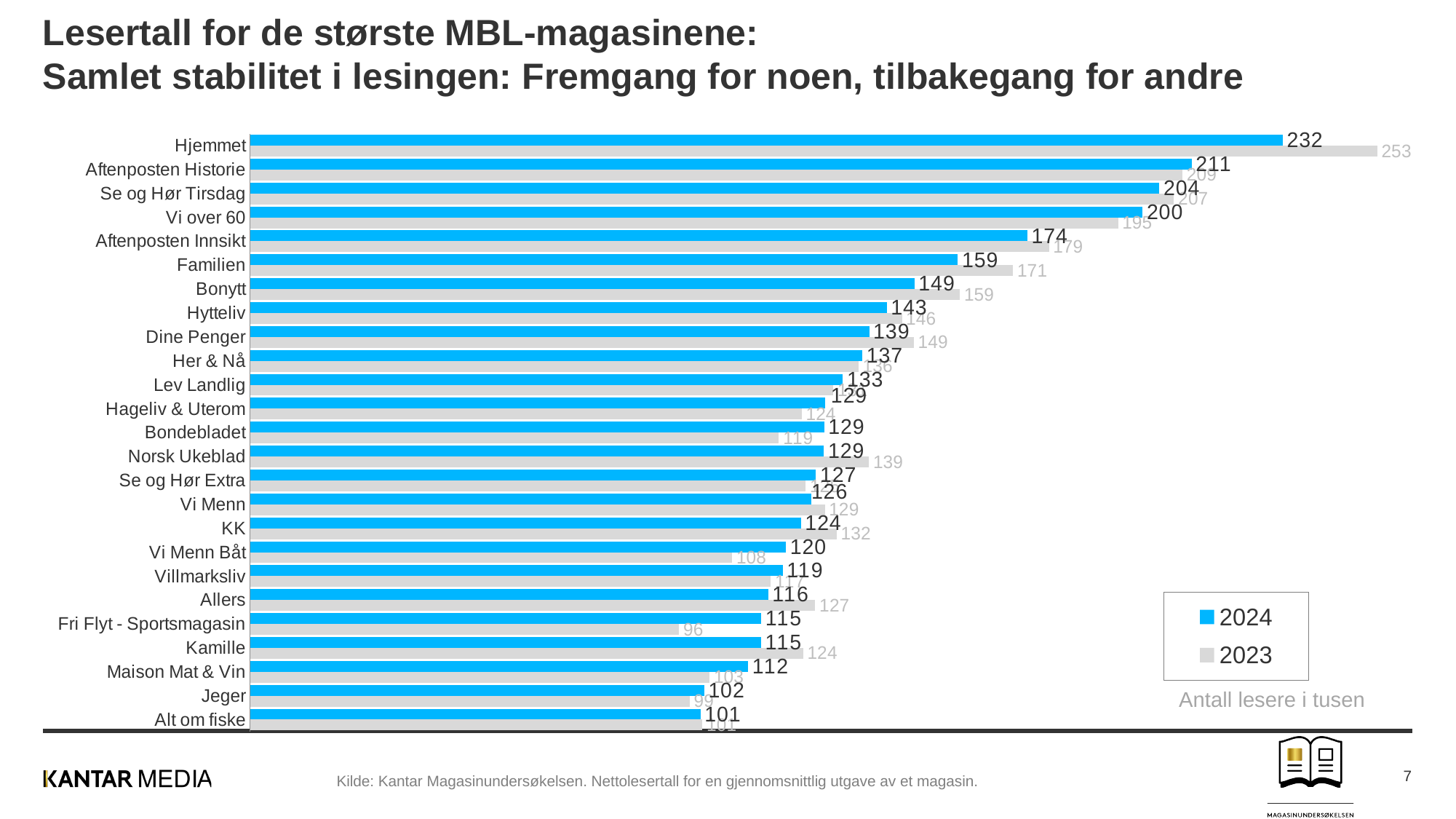
What is the 2023 value for Fri Flyt - Sportsmagasin? 96 How many magazines are shown in the chart? 25 How many series does the legend list? 2 Which magazine has the highest 2024 value? Hjemmet What is the 2023 value for Hjemmet? 253 What is the 2024 value for Hjemmet? 232 What kind of chart is shown on the slide? Bar chart What is the difference between the 2023 and 2024 values for Hjemmet? 21 What is the difference between the 2024 and 2023 values for Vi Menn Båt? 12 For Familien, which year has the larger value, 2024 or 2023? 2023 What are the two entries in the chart's legend? 2024 and 2023 Which magazine has the lowest 2024 value? Alt om fiske